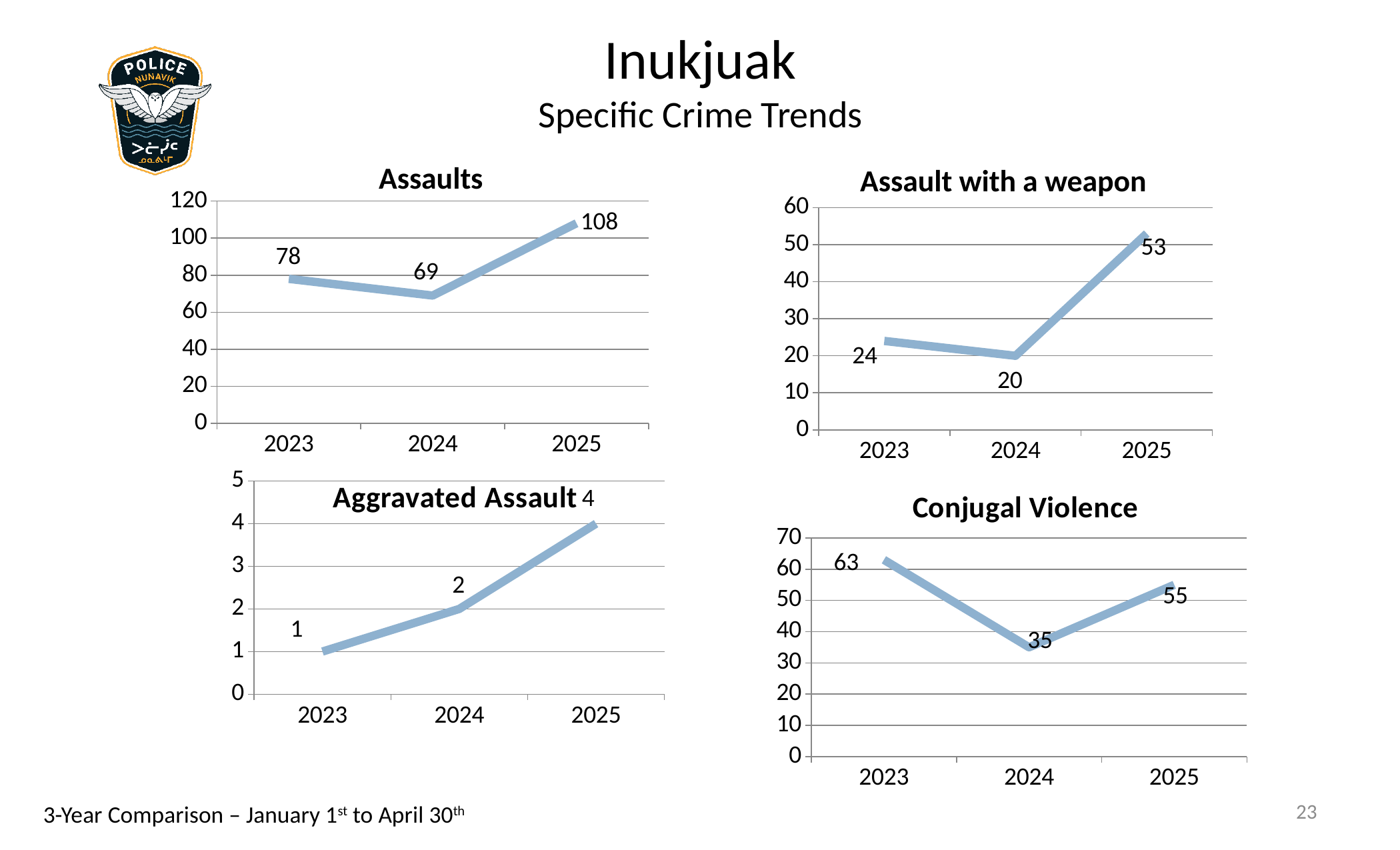
In the Conjugal Violence chart, which is larger, the value for 2023 or the value for 2025? 2023 In the Conjugal Violence chart, which year has the lowest value? 2024 In the Aggravated Assault chart, do the values rise or fall from 2023 to 2025? rise In the Conjugal Violence chart, what is the value for 2023? 63 In the Aggravated Assault chart, which year has the highest value? 2025 In the Assault with a weapon chart, what is the difference between the 2025 and 2023 values? 29 In the Assault with a weapon chart, what is the value for 2024? 20 In the Assaults chart, is the value for 2024 greater or less than 80? less In the Assaults chart, what is the value for 2025? 108 What kind of chart is the Assault with a weapon chart? line chart In the Assaults chart, what is the difference between the 2025 and 2024 values? 39 How many years are plotted in the Aggravated Assault chart? 3